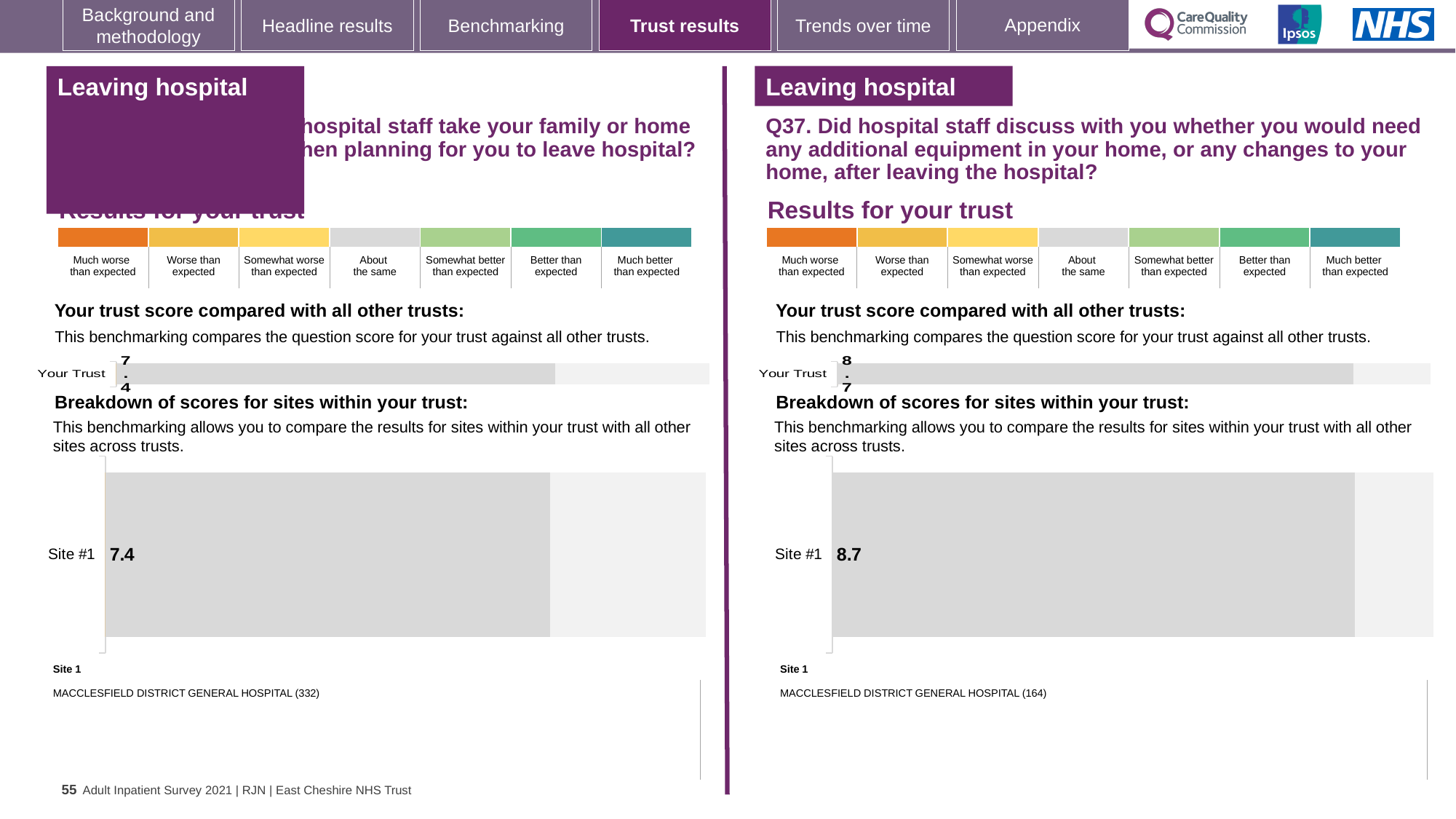
On the right half of the slide (Q37), what is the score shown for Site #1? 8.7 On the left half of the slide, what is the score shown for Site #1? 7.4 On the left half of the slide, what is the score shown for Your Trust? 7.4 Which hospital is listed as Site 1 on the left half of the slide? MACCLESFIELD DISTRICT GENERAL HOSPITAL (332) What kind of chart is used to show the Site #1 score on the right half of the slide? Bar chart Which hospital is listed as Site 1 on the right half of the slide (Q37)? MACCLESFIELD DISTRICT GENERAL HOSPITAL (164) What is the difference between the Site #1 score on the right half of the slide (Q37) and the Site #1 score on the left half? 1.3 How many sites are shown in the site breakdown chart on the left half of the slide? 1 Which Site #1 score is larger: the one on the left half of the slide or the one on the right half (Q37)? Right half (Q37) On the right half of the slide (Q37), what is the score shown for Your Trust? 8.7 How many sites are shown in the site breakdown chart on the right half of the slide (Q37)? 1